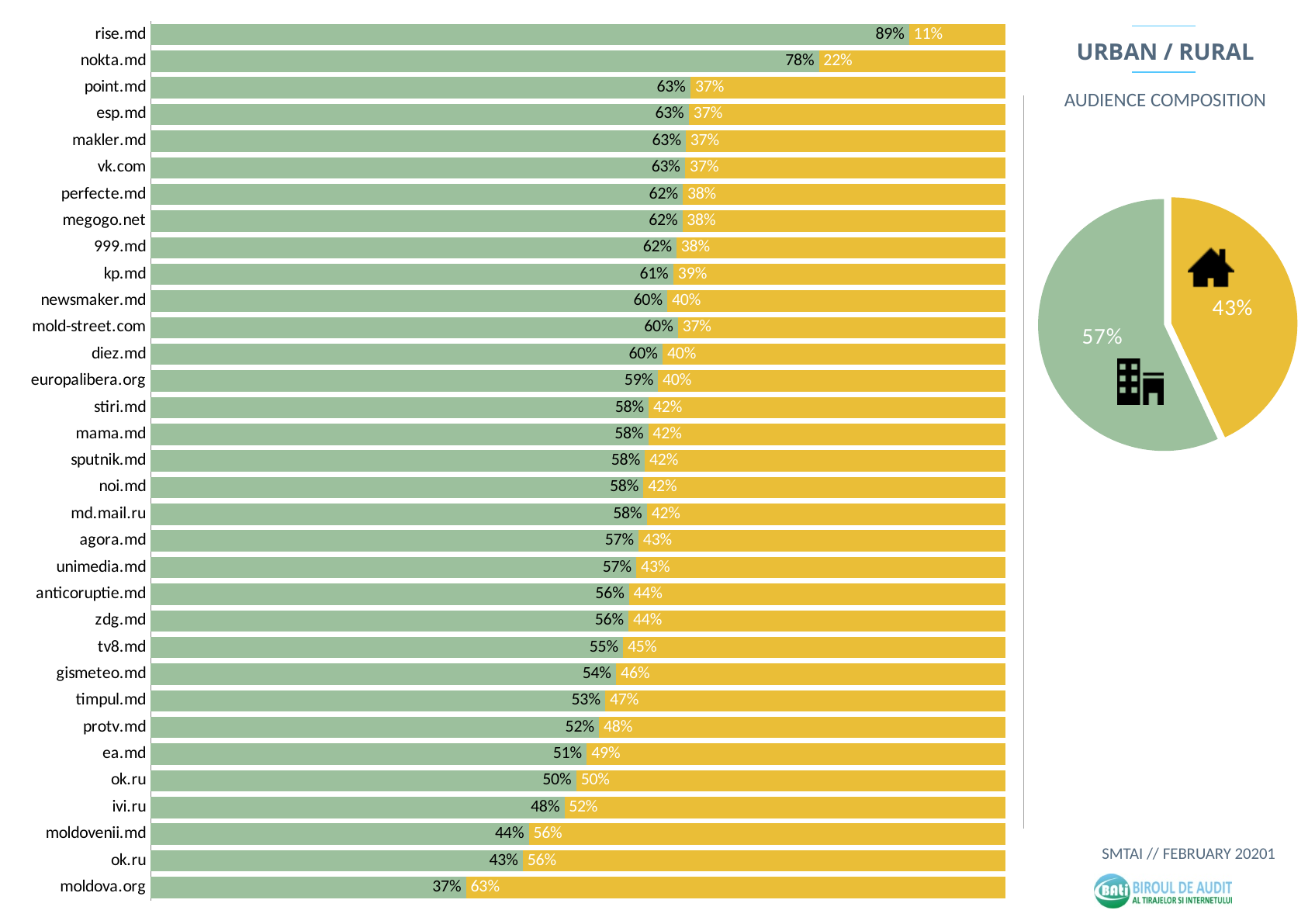
What type of chart is used to show the per-site audience composition on the left of the slide? Bar chart In the pie chart, what share does the green slice represent? 57% In the bar chart, what is the difference between the green segment of rise.md and the green segment of nokta.md? 11 percentage points In the bar chart, what is the value of the yellow segment for moldova.org? 63% In the bar chart, what is the value of the green segment for rise.md? 89% In the bar chart, which site has a larger green segment, point.md or timpul.md? point.md In the bar chart, what is the value of the green segment for ivi.ru? 48% How many bars (sites) are shown in the bar chart? 33 In the bar chart, which site has the largest green segment? rise.md What is the title shown at the top right of the slide? URBAN / RURAL In the bar chart, which site has the smallest green segment? moldova.org In the pie chart, what is the value of the yellow slice? 43%